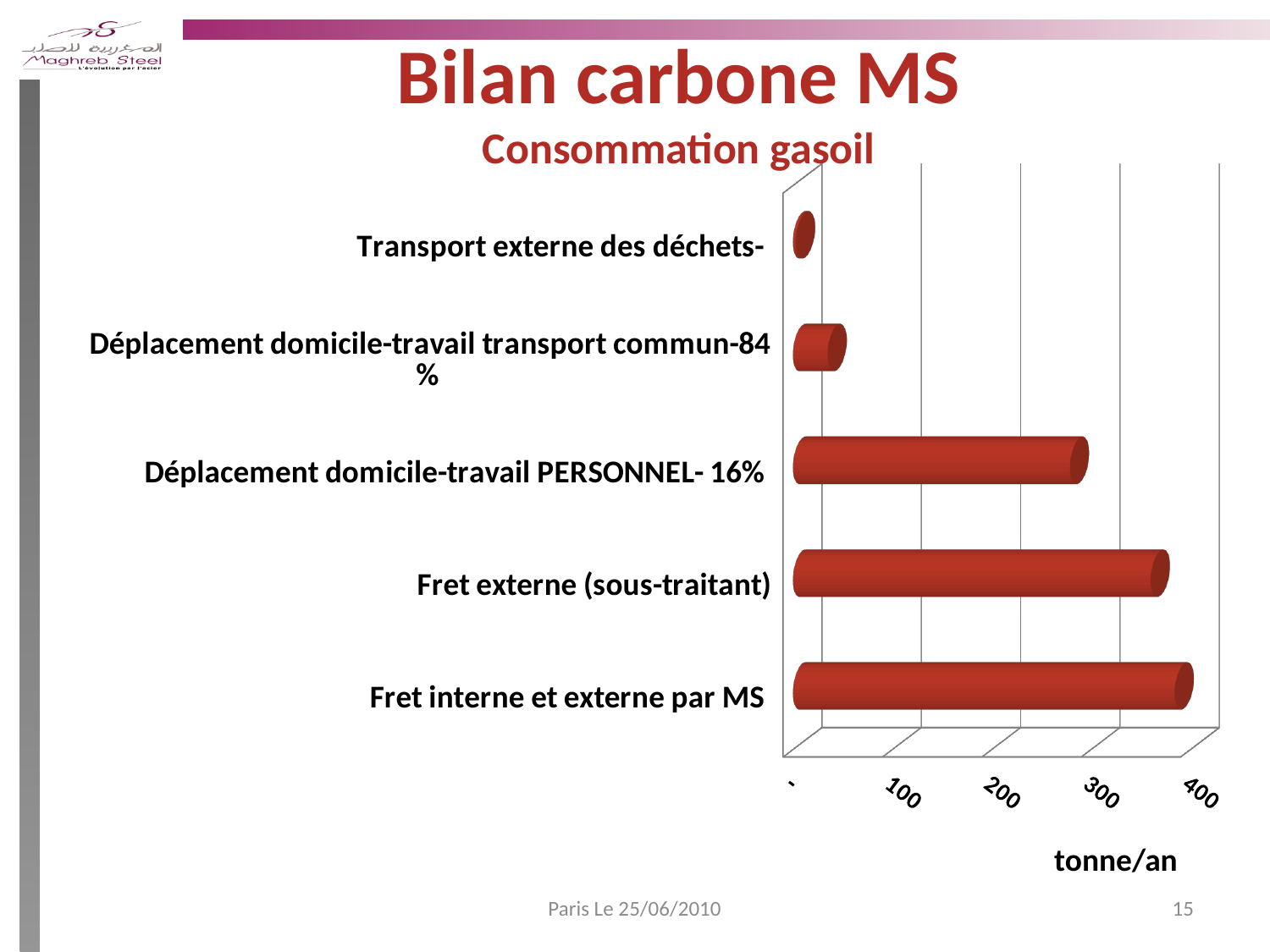
Which is larger: the value for Fret externe (sous-traitant) or the value for Déplacement domicile-travail PERSONNEL- 16%? Fret externe (sous-traitant) Is the value for Fret interne et externe par MS greater or less than 300? greater What kind of chart is shown on the slide? bar chart Is the value for Déplacement domicile-travail transport commun-84 % greater or less than 100? less Is the value for Fret externe (sous-traitant) greater or less than 300? greater What is the title of the chart? Consommation gasoil What unit is shown on the value axis of the chart? tonne/an How many categories are plotted in the chart? 5 Which is larger: the value for Déplacement domicile-travail transport commun-84 % or the value for Transport externe des déchets? Déplacement domicile-travail transport commun-84 % Which category has the lowest value in the chart? Transport externe des déchets